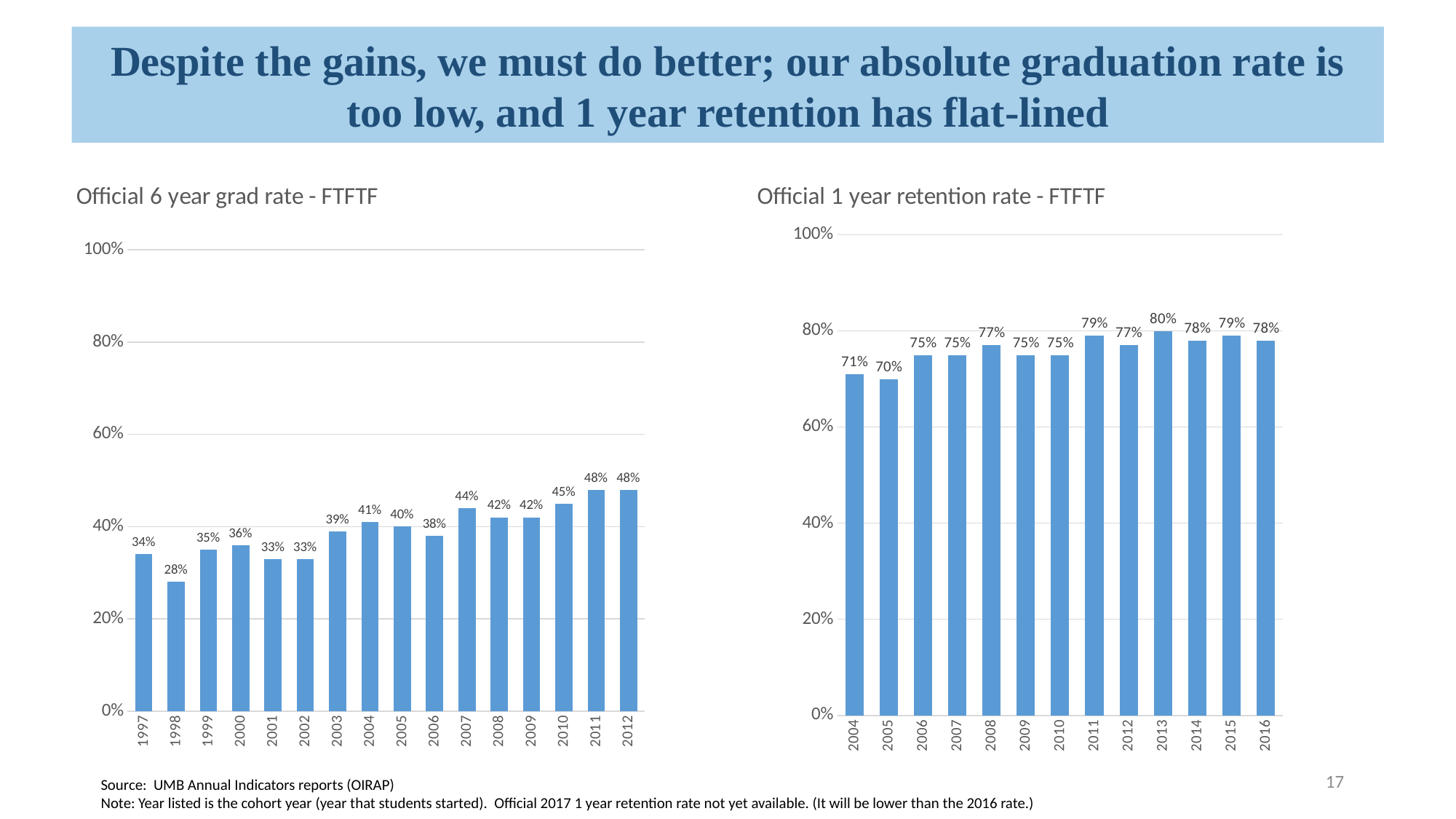
In the 'Official 6 year grad rate - FTFTF' chart, which year has the lowest value? 1998 In the 'Official 6 year grad rate - FTFTF' chart, what is the value for 1998? 28% In the 'Official 1 year retention rate - FTFTF' chart, what is the value for 2013? 80% What type of chart is the 'Official 1 year retention rate - FTFTF' chart? bar chart In the 'Official 6 year grad rate - FTFTF' chart, what is the value for 2007? 44% In the 'Official 6 year grad rate - FTFTF' chart, what is the difference between the values for 2012 and 1997? 14% In the 'Official 6 year grad rate - FTFTF' chart, how many years are shown? 16 In the 'Official 1 year retention rate - FTFTF' chart, which year has the highest value? 2013 In the 'Official 6 year grad rate - FTFTF' chart, do the values generally rise or fall from 1997 to 2012? rise In the 'Official 1 year retention rate - FTFTF' chart, how many years are shown? 13 In the 'Official 1 year retention rate - FTFTF' chart, which year has the lowest value? 2005 In the 'Official 1 year retention rate - FTFTF' chart, which is larger, the value for 2011 or the value for 2012? 2011